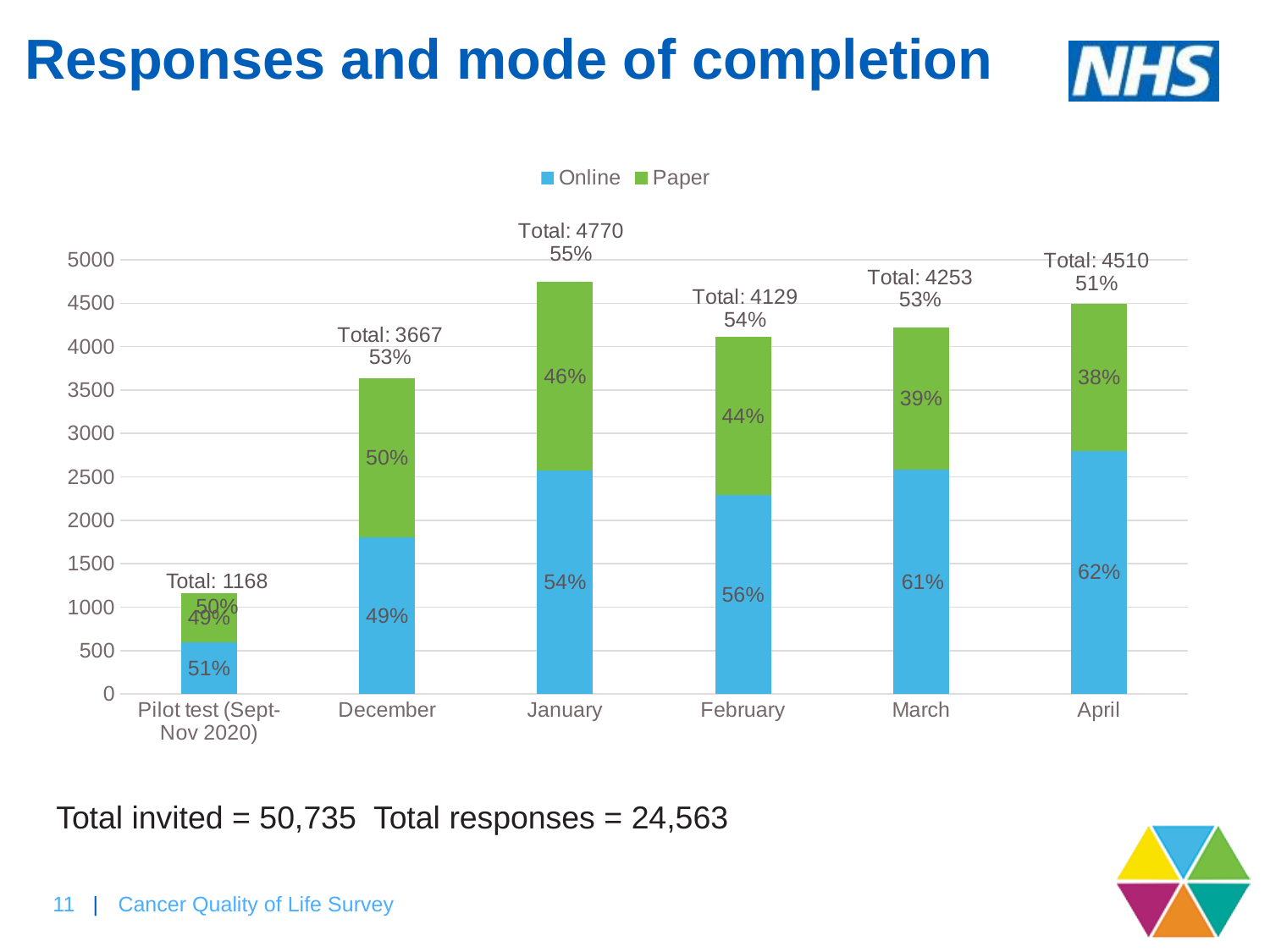
Does the Online percentage rise or fall from December to April? Rise Which has a larger total of responses, March or February? March What percentage of February responses were completed on Paper? 44% What is the total number of responses shown for January? 4770 What kind of chart is shown on the slide? Stacked bar chart How many series does the legend list? 2 Which category has the highest total responses? January What percentage of April responses were completed Online? 62% How many categories are shown along the x axis? 6 Is the Online value for April greater or less than 2500? greater What is the difference between the total responses for January and December? 1103 Which category has the lowest total responses? Pilot test (Sept-Nov 2020)